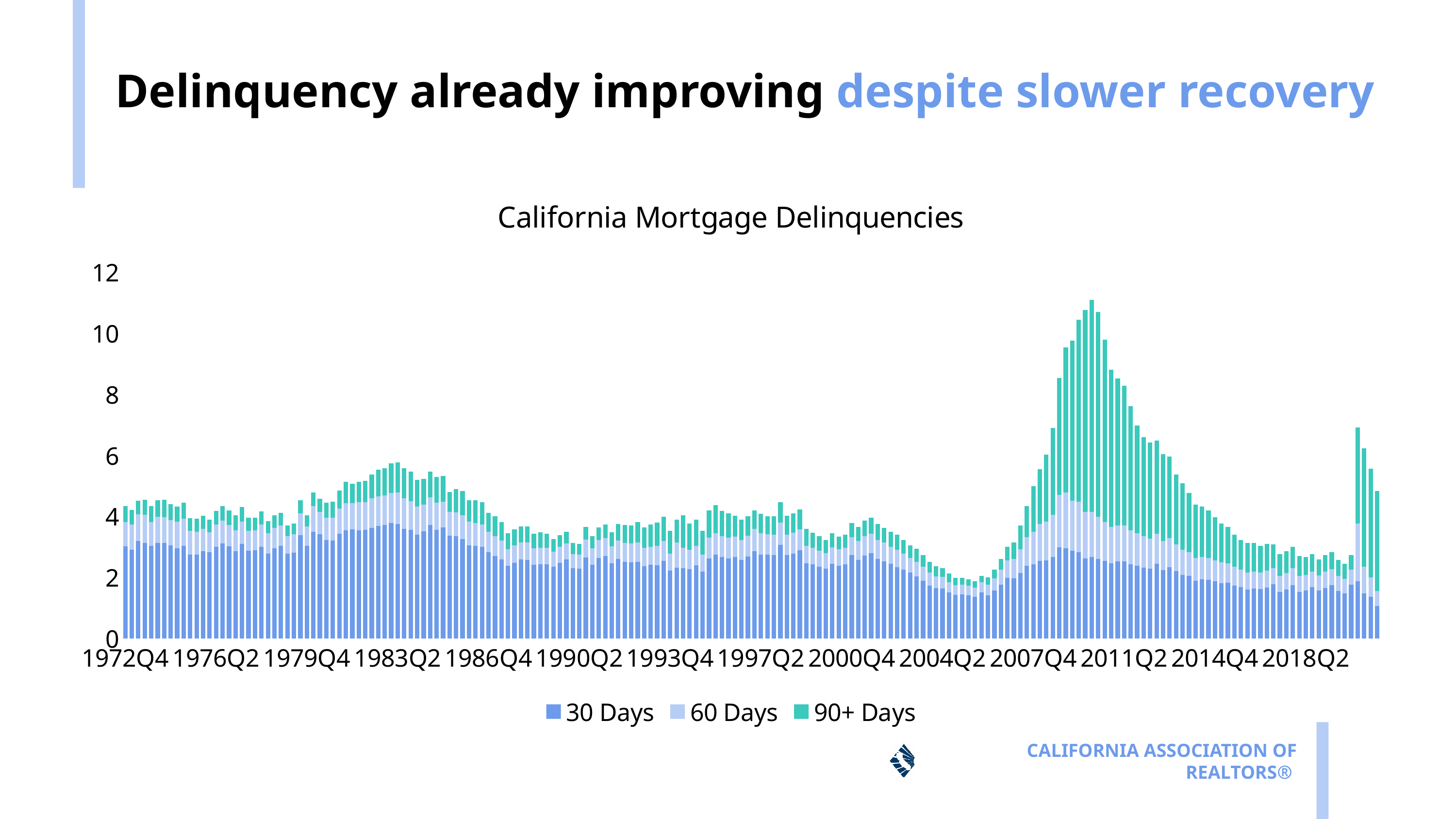
Is the highest stacked bar on the chart greater or less than 10? greater What is the title of the chart? California Mortgage Delinquencies Is the total delinquency value for 2018Q2 greater or less than 4? less Which has the larger total delinquency value, 1983Q2 or 2004Q2? 1983Q2 Which series forms the top segment of each stacked bar? 90+ Days Is the total delinquency value for 1983Q2 greater or less than 4? greater How many series does the legend list? 3 What kind of chart is shown on the slide? Stacked bar chart Do the total delinquency values rise or fall between 2011Q2 and 2018Q2? fall Which has the larger total delinquency value, 2011Q2 or 1972Q4? 2011Q2